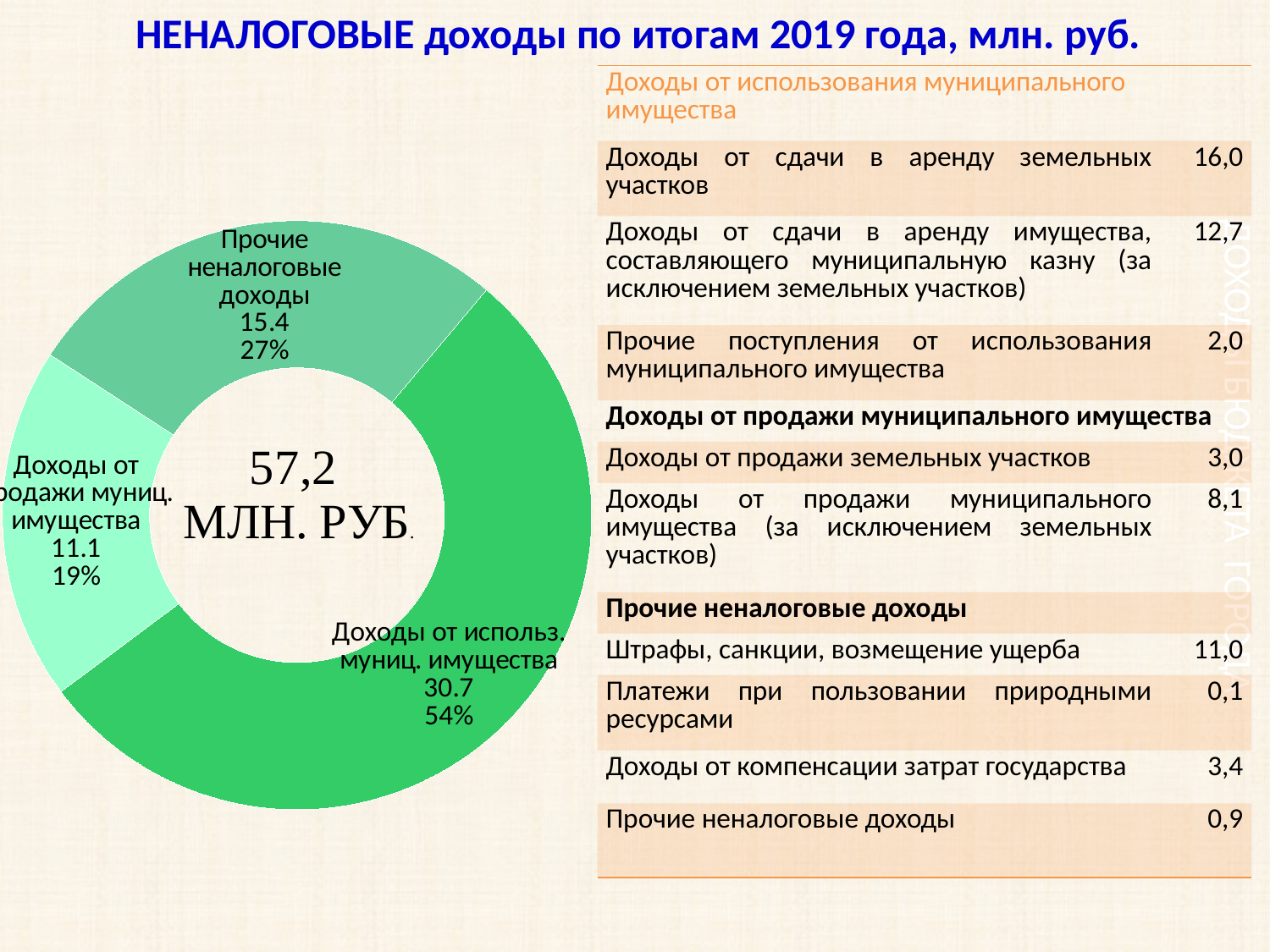
What share of the doughnut does "Прочие неналоговые доходы" take? 27% Which slice of the doughnut chart is the largest? Доходы от использ. муниц. имущества What value is shown for the slice "Доходы от использ. муниц. имущества"? 30.7 What kind of chart is shown on the slide? Doughnut (pie) chart What share of the doughnut does "Доходы от продажи муниц. имущества" take? 19% Which slice of the doughnut chart is the smallest? Доходы от продажи муниц. имущества What share of the doughnut does "Доходы от использ. муниц. имущества" take? 54% What value is shown for the slice "Доходы от продажи муниц. имущества"? 11.1 What total is printed in the centre of the doughnut chart? 57,2 МЛН. РУБ. What value is shown for the slice "Прочие неналоговые доходы"? 15.4 What is the difference between the values for "Доходы от использ. муниц. имущества" and "Прочие неналоговые доходы"? 15.3 How many slices does the doughnut chart have? 3